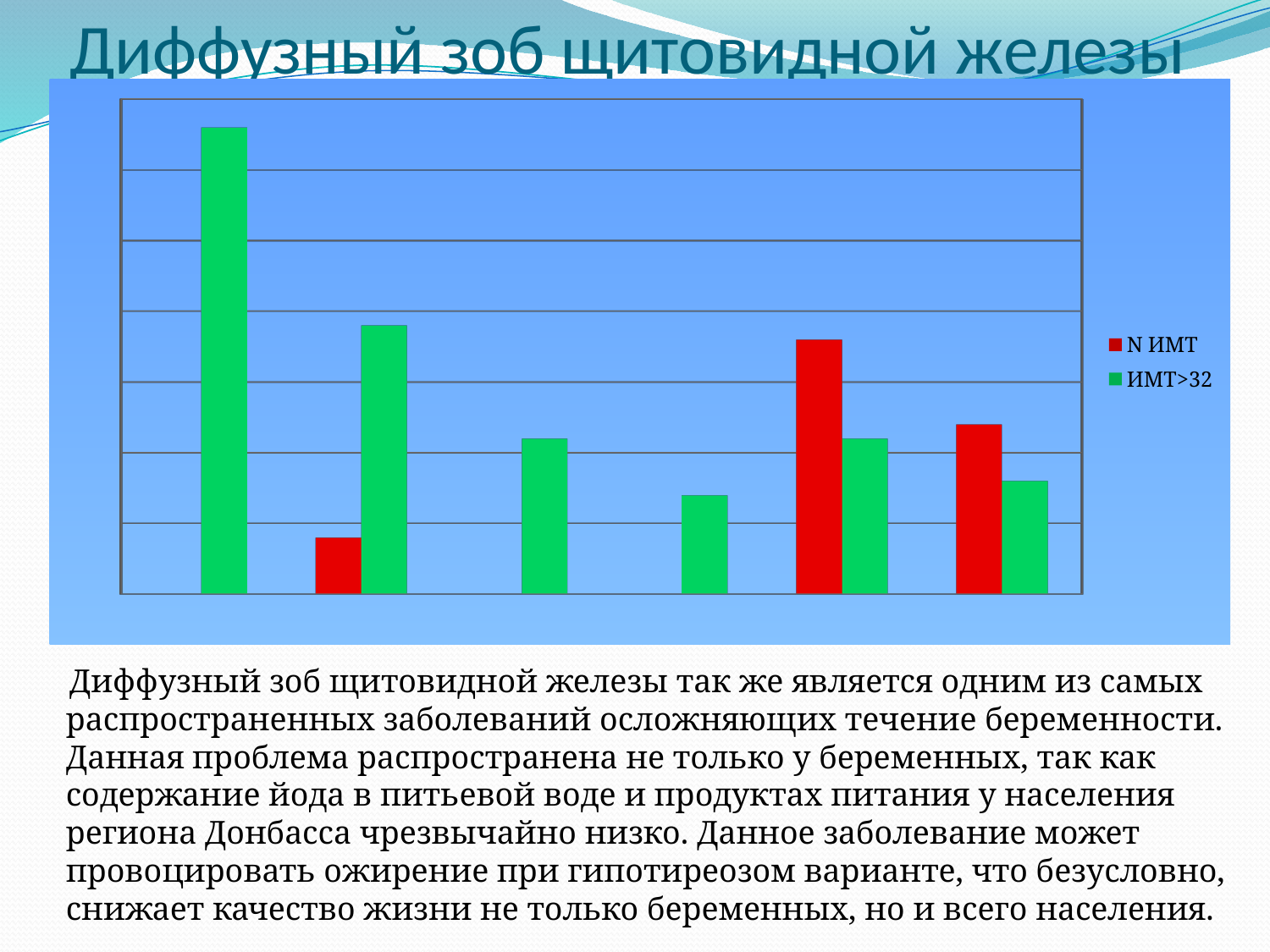
How many groups of bars are there along the x axis of the chart? 6 Which series does the shortest bar in the chart belong to? N ИМТ Which colour represents the ИМТ>32 series in the chart? green Which series does the tallest bar in the chart belong to? ИМТ>32 In the second group of bars from the left, which series has the taller bar, N ИМТ or ИМТ>32? ИМТ>32 How many green (ИМТ>32) bars are plotted in the chart? 6 What kind of chart is shown on the slide? bar chart How many red (N ИМТ) bars are plotted in the chart? 3 In the rightmost group of bars, which series has the taller bar, N ИМТ or ИМТ>32? N ИМТ What are the two series named in the chart legend? N ИМТ and ИМТ>32 How many series does the chart legend list? 2